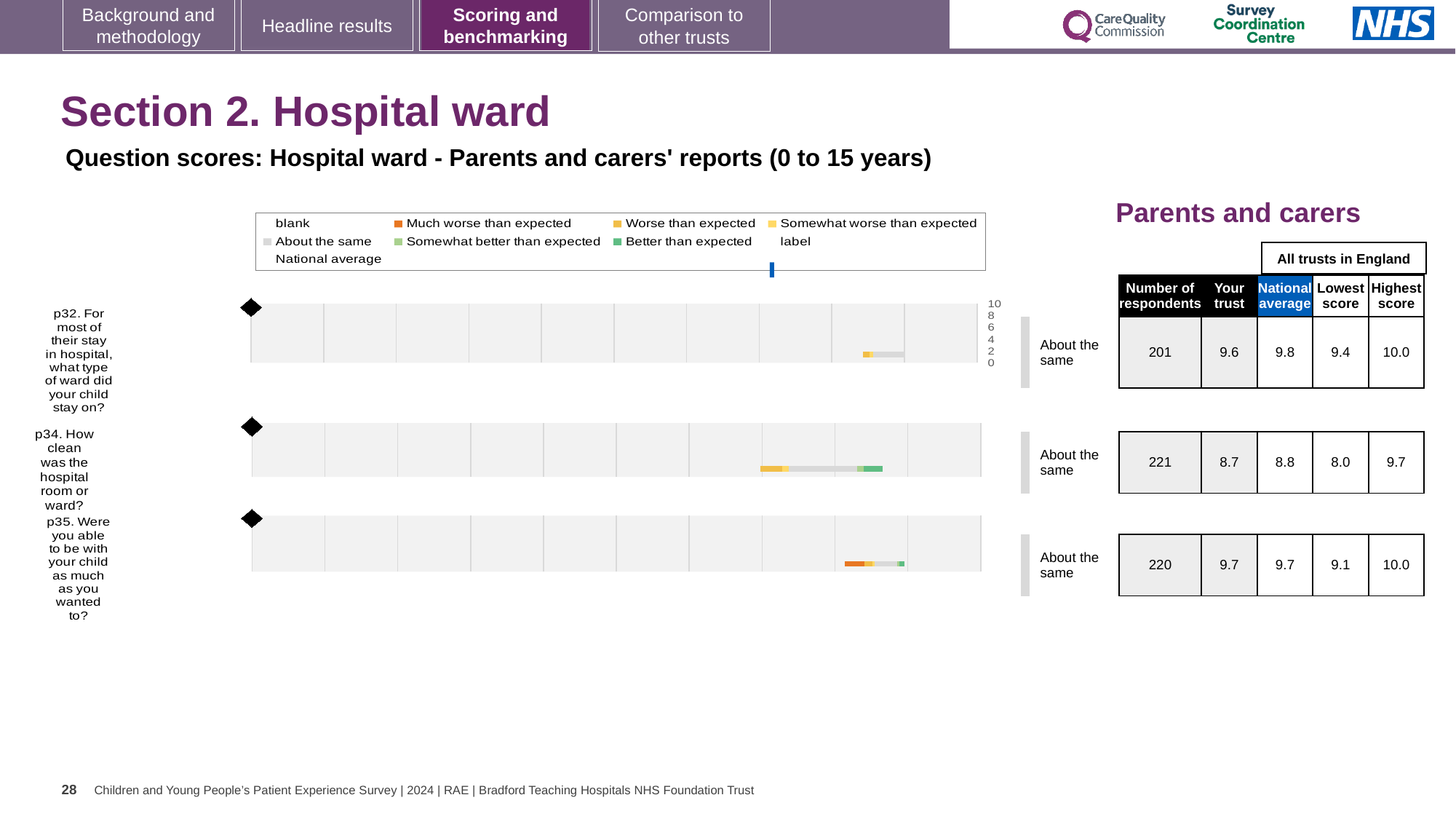
For question p34, what is the difference between the national average and the 'Your trust' score? 0.1 What is the highest score across all trusts in England for question p34? 9.7 What is the national average score for question p35 (were you able to be with your child as much as you wanted to)? 9.7 Which question has the lowest 'Your trust' score? p34 What is the 'Your trust' score for question p34 (how clean was the hospital room or ward)? 8.7 What kind of chart is used to show the question scores? Bar chart How many questions are plotted on the slide? 3 How many respondents are shown for question p32 (what type of ward did your child stay on)? 201 Which question has the highest 'Your trust' score? p35 What benchmark category is shown next to the chart for question p34? About the same Is the 'Your trust' score higher for question p32 or question p35? p35 What is the lowest score across all trusts in England for question p32? 9.4